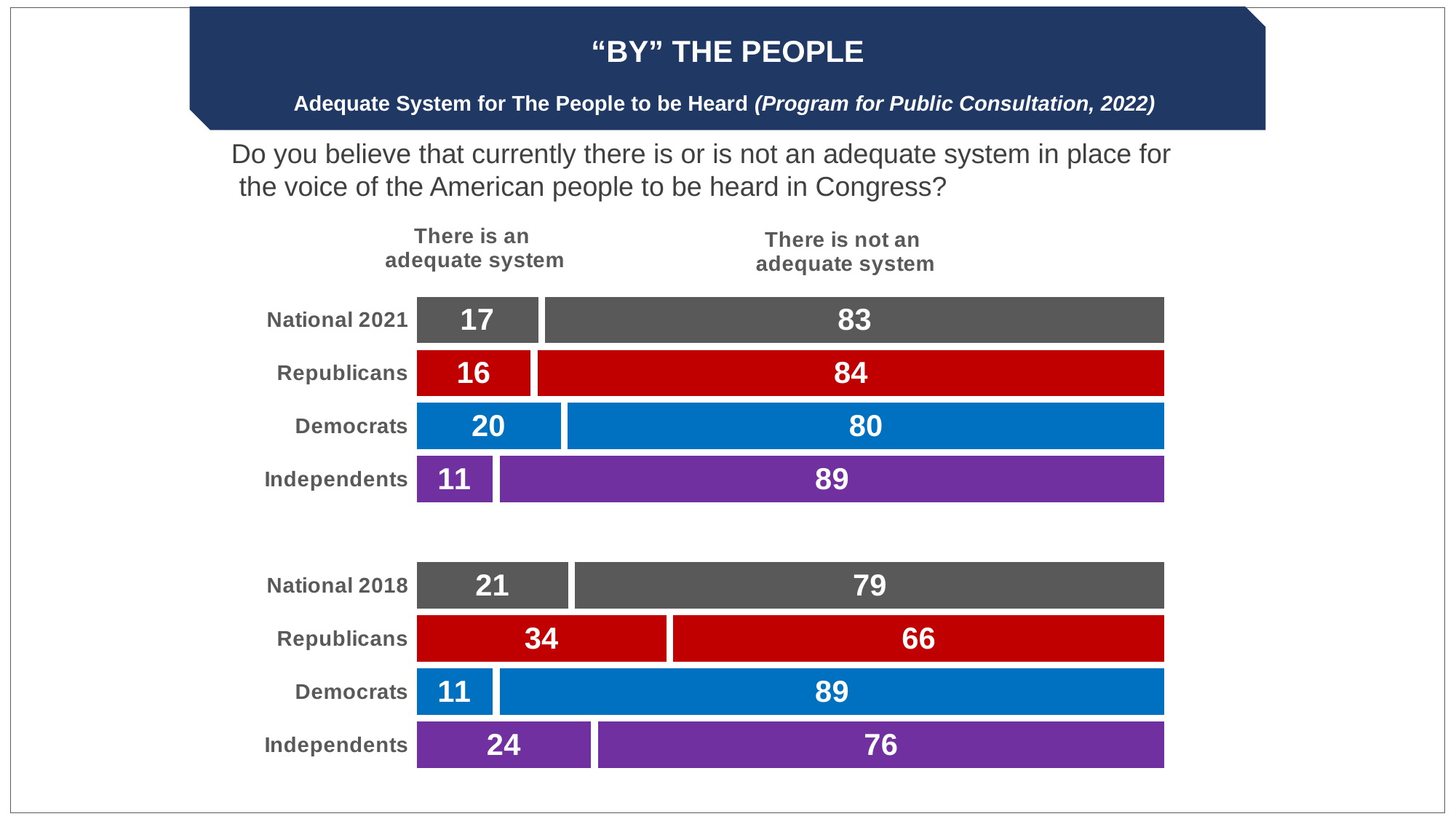
What is the difference between the "There is an adequate system" values for Republicans in 2018 and Republicans in 2021? 18 What value is shown for Independents in the 2021 group under "There is not an adequate system"? 89 Which group in the 2021 set has the lowest value for "There is an adequate system"? Independents What is the total of the two segments in the National 2021 bar? 100 What kind of chart is shown on the slide? Stacked bar chart What percentage of Republicans in the 2021 group said there is an adequate system? 16 What value is shown for National 2018 under "There is not an adequate system"? 79 What value is shown for Republicans in the 2018 group under "There is an adequate system"? 34 Which is larger: the "There is an adequate system" value for Democrats in 2021 or for Democrats in 2018? Democrats in 2021 How many bars are shown in the chart in total? 8 Which group in the 2018 set has the highest value for "There is an adequate system"? Republicans What colour are the bars for Independents? Purple